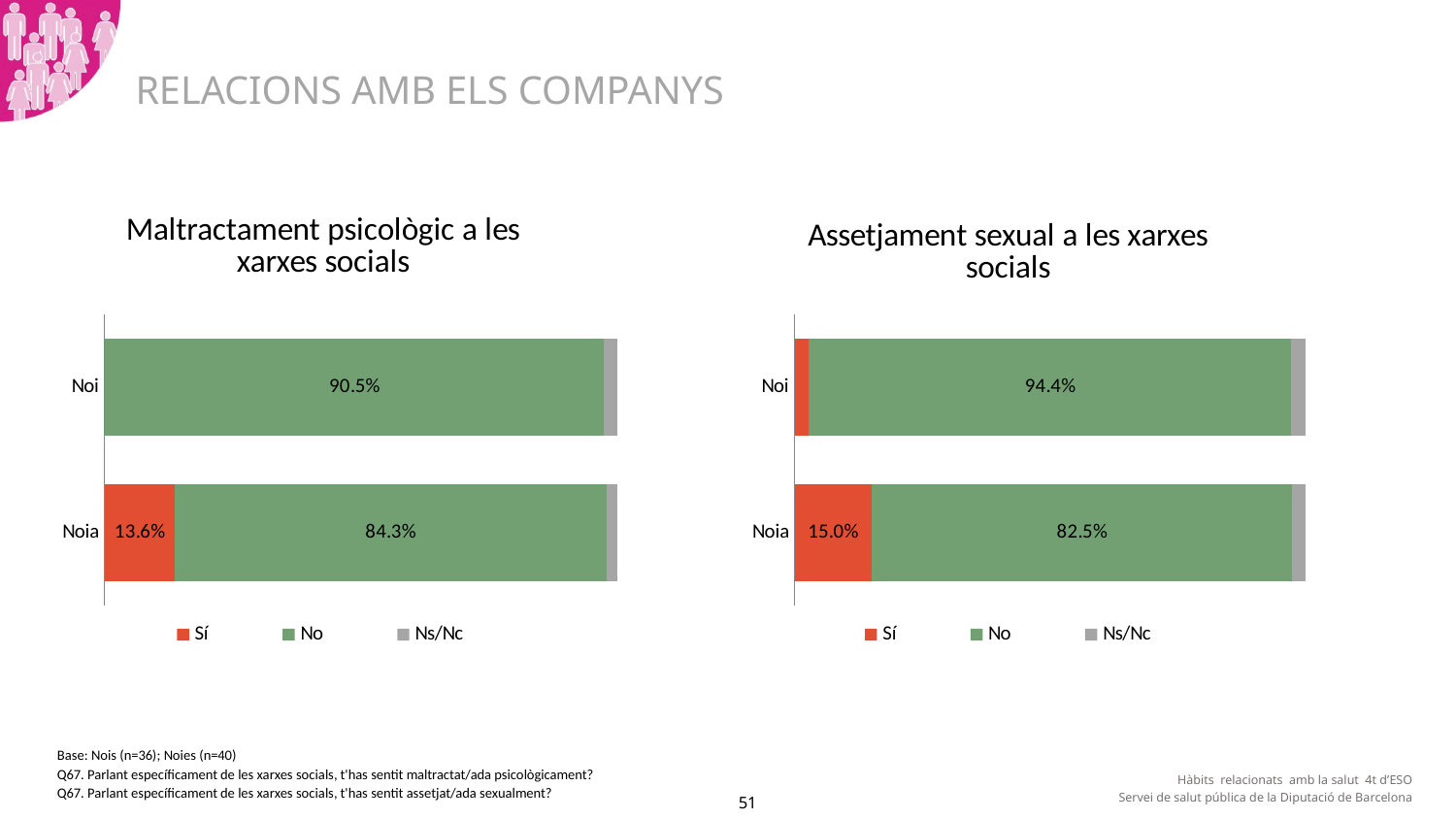
In the chart titled "Assetjament sexual a les xarxes socials", what is the difference between the "No" values for Noi and Noia? 11.9 percentage points In the chart titled "Assetjament sexual a les xarxes socials", what is the "No" value for Noi? 94.4% How many categories are shown on the y axis of the chart titled "Assetjament sexual a les xarxes socials"? 2 In the chart titled "Maltractament psicològic a les xarxes socials", what is the difference between the "No" values for Noi and Noia? 6.2 percentage points In the chart titled "Maltractament psicològic a les xarxes socials", which category has the higher "No" value, Noi or Noia? Noi What kind of chart is the chart titled "Assetjament sexual a les xarxes socials"? Stacked bar chart In the chart titled "Assetjament sexual a les xarxes socials", what is the "No" value for Noia? 82.5% In the chart titled "Maltractament psicològic a les xarxes socials", what is the "No" value for Noia? 84.3% In the chart titled "Maltractament psicològic a les xarxes socials", what is the "No" value for Noi? 90.5% How many series does the legend of the chart titled "Maltractament psicològic a les xarxes socials" list? 3 In the chart titled "Assetjament sexual a les xarxes socials", what is the "Sí" value for Noia? 15.0% In the chart titled "Maltractament psicològic a les xarxes socials", what is the "Sí" value for Noia? 13.6%